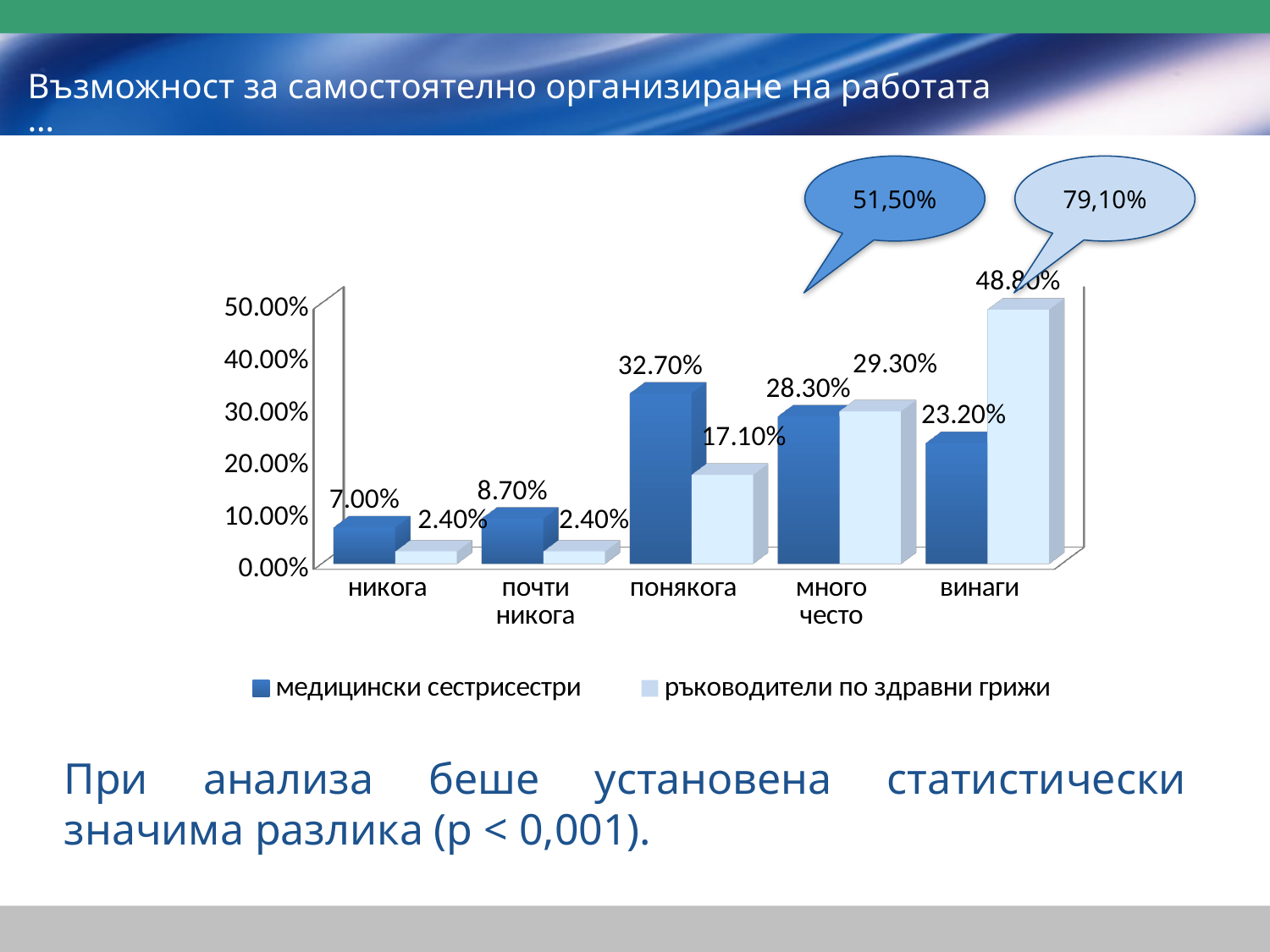
Which category has the lowest value for 'медицински сестрисестри'? никога Is the value for 'ръководители по здравни грижи' in the 'винаги' category greater or less than 40.00%? greater Which category has the highest value for 'медицински сестрисестри'? понякога What is the value for 'медицински сестрисестри' in the 'понякога' category? 32.70% How many categories are shown on the x axis of the chart? 5 What is the value for 'ръководители по здравни грижи' in the 'никога' category? 2.40% What is the value for 'ръководители по здравни грижи' in the 'винаги' category? 48.80% What type of chart is shown on the slide? bar chart What is the difference between the 'ръководители по здравни грижи' and 'медицински сестрисестри' values in the 'винаги' category? 25.60% How many series does the chart legend list? 2 What value is shown in the light blue callout above the chart? 79,10% In the 'понякога' category, which series has the larger value? медицински сестрисестри